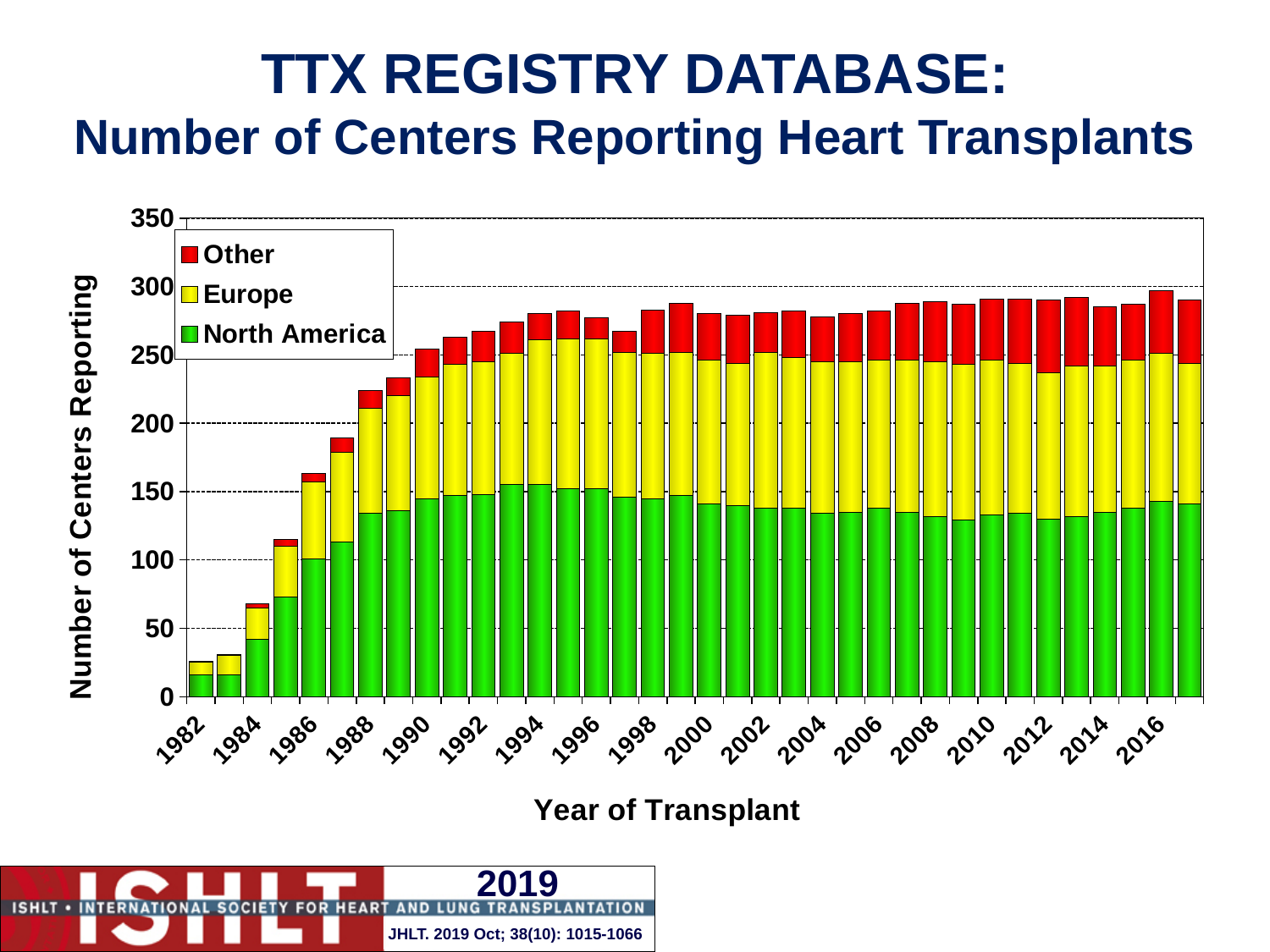
How many series does the legend list? 3 Is the total number of centers reporting in 1982 greater or less than 50? less Is the total number of centers reporting in 2000 greater or less than 300? less Is the total number of centers reporting in 1988 greater or less than 200? greater Which is larger, the total number of centers reporting in 1986 or in 1992? 1992 What kind of chart is shown on the slide? stacked bar chart What is the title of the y axis? Number of Centers Reporting Which year has the lowest total number of centers reporting? 1982 Do the total numbers of centers reporting rise or fall from 1982 to 1990? rise Which series is shown in green in the legend? North America